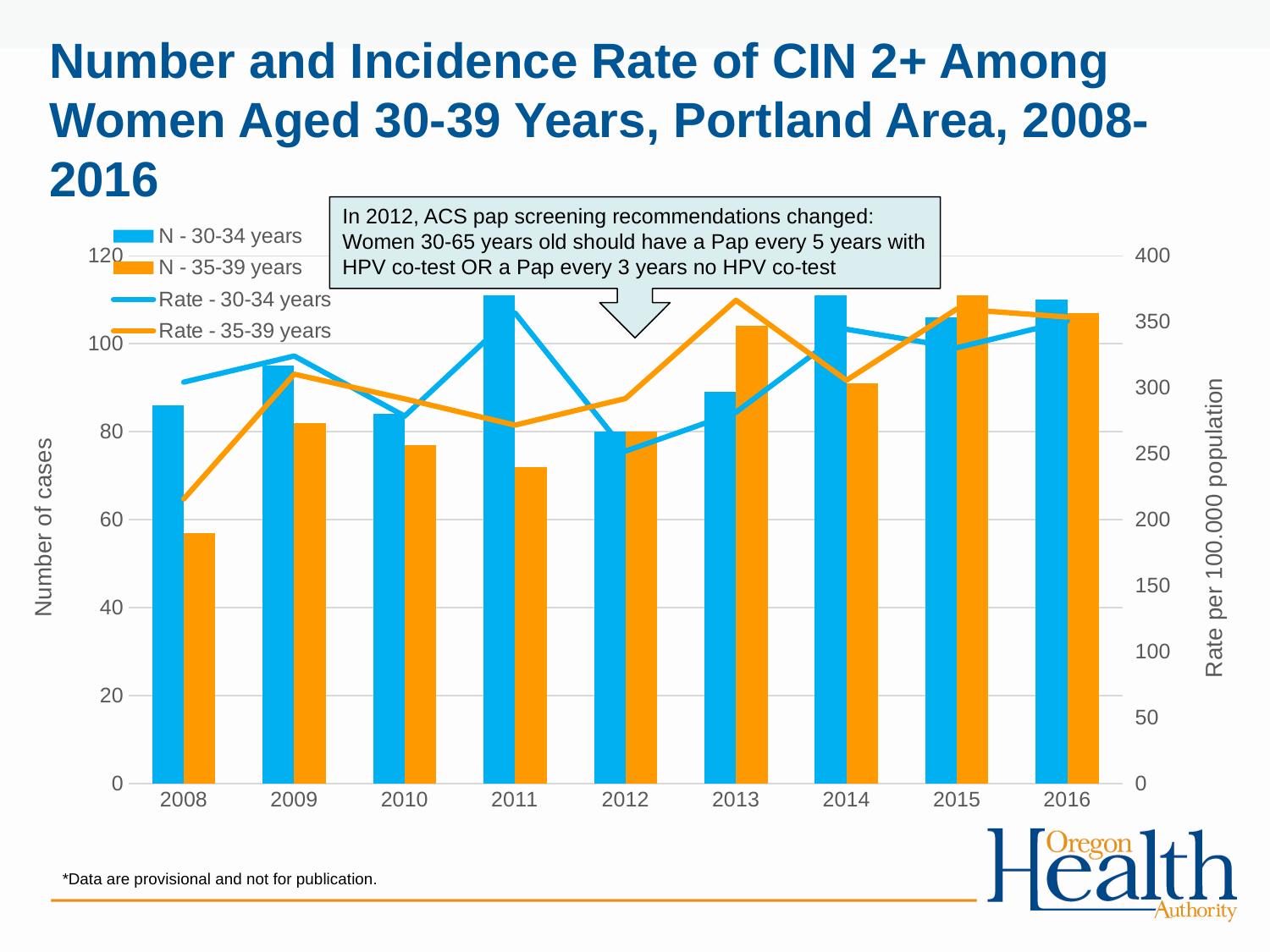
How many years are shown on the x axis? 9 In 2008, which is larger: N - 30-34 years or N - 35-39 years? N - 30-34 years Does the Rate - 35-39 years line rise or fall from 2008 to 2013? rise In 2013, which is larger: N - 30-34 years or N - 35-39 years? N - 35-39 years Is the value for N - 30-34 years in 2012 greater or less than 100? less Which year has the highest bar for N - 35-39 years? 2015 What kind of chart is this? Combined bar and line chart Is the value for N - 35-39 years in 2008 greater or less than 80? less Which year has the lowest bar for N - 35-39 years? 2008 How many series does the legend list? 4 What is the label of the right-hand vertical axis? Rate per 100,000 population Is the value for N - 30-34 years in 2011 greater or less than 100? greater